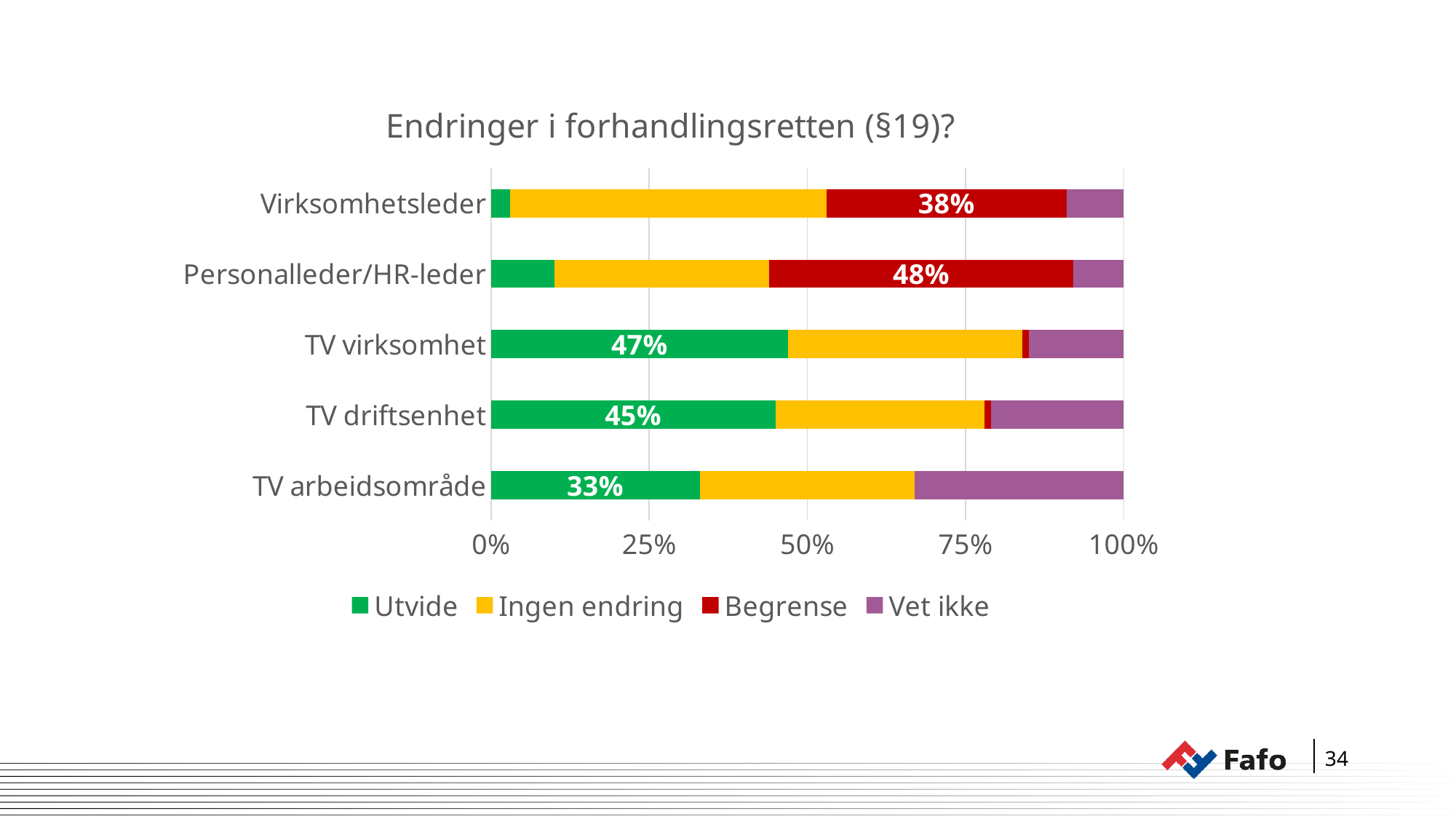
How many categories are shown on the y axis? 5 Which has a larger Utvide value, TV virksomhet or TV arbeidsområde? TV virksomhet What is the Begrense value for Virksomhetsleder? 38% What is the title of the chart? Endringer i forhandlingsretten (§19)? How many series does the legend list? 4 What kind of chart is shown? Stacked bar chart What is the Utvide value for TV driftsenhet? 45% What is the Utvide value for TV arbeidsområde? 33% What is the Begrense value for Personalleder/HR-leder? 48% What is the difference between the Begrense values for Personalleder/HR-leder and Virksomhetsleder? 10% Is the Utvide value for Virksomhetsleder greater or less than 25%? less What is the Utvide value for TV virksomhet? 47%